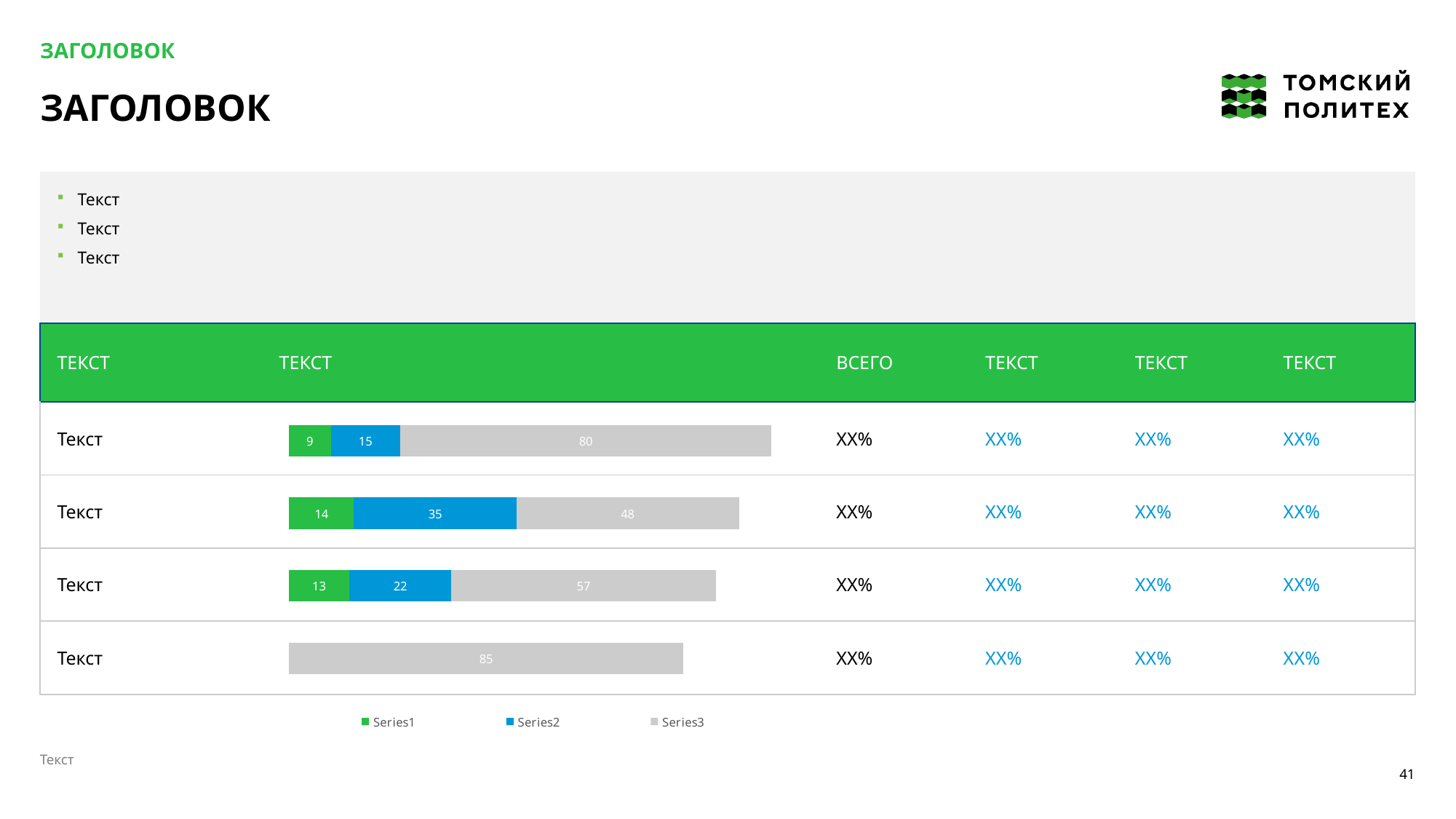
What is the total of the first (top) stacked bar? 104 What is the Series1 value in the third bar from the top? 13 What is the value shown in the fourth (bottom) bar? 85 What is the Series3 value in the first (top) bar? 80 What is the Series2 value in the second bar from the top? 35 What type of chart is shown in the table on the slide? stacked bar chart How many bars (rows) does the chart contain? 4 Which colour represents Series1 in the legend? green Which bar has the highest Series2 value? the second bar from the top What is the difference between the Series2 values of the second bar and the first bar? 20 How many series does the chart legend list? 3